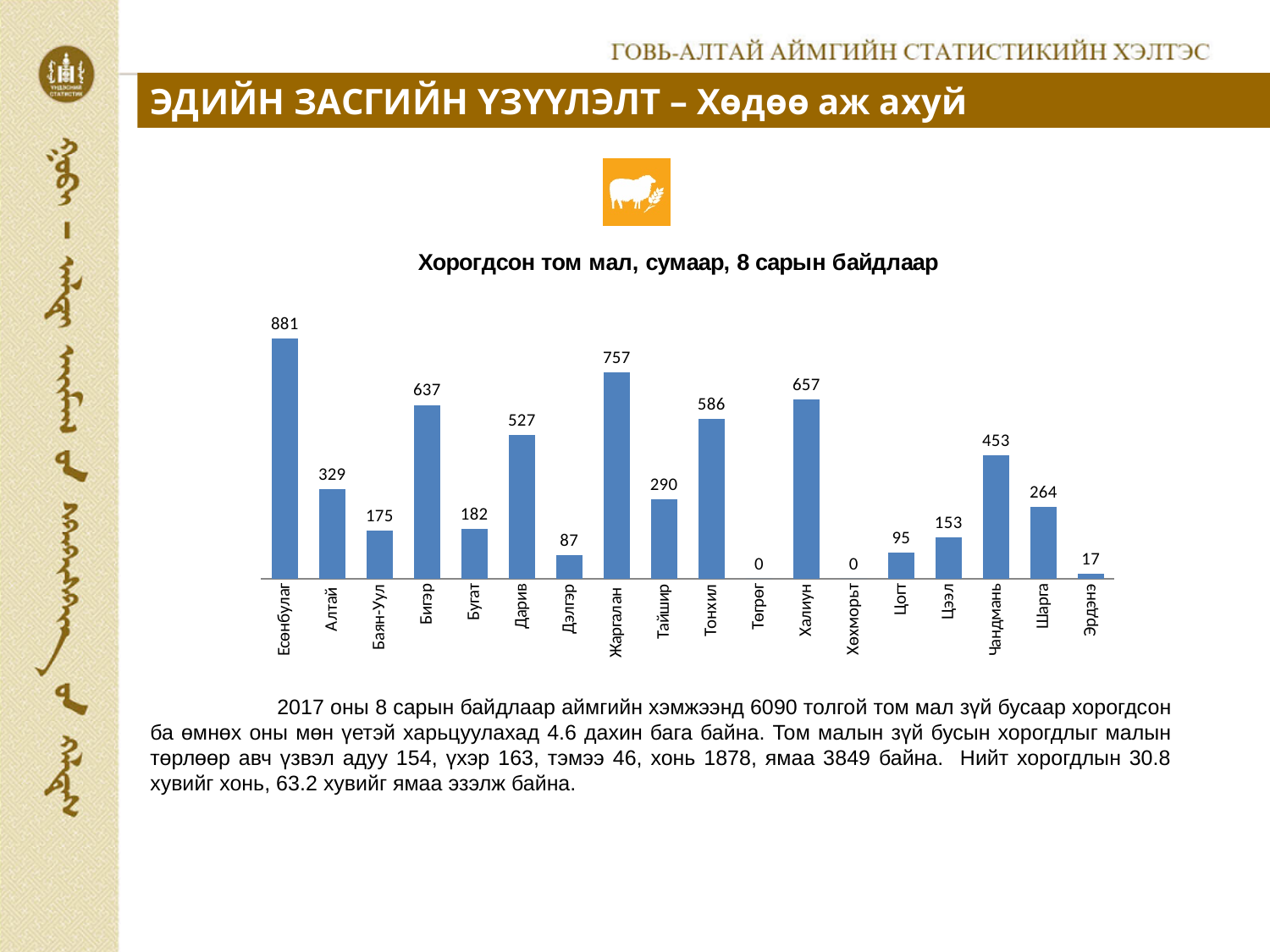
What is the difference between the values for Есөнбулаг and Жаргалан? 124 Which is larger, the value for Тонхил or the value for Чандмань? Тонхил What kind of chart is shown? Bar chart What is the value for Жаргалан? 757 What is the value for Есөнбулаг? 881 Which sum has the highest value? Есөнбулаг Which is larger, the value for Алтай or the value for Шарга? Алтай What is the value for Цээл? 153 What is the title of the chart? Хорогдсон том мал, сумаар, 8 сарын байдлаар Which sums have a value of 0? Төгрөг and Хөхморьт How many sums are shown on the x axis? 18 What is the difference between the values for Бигэр and Халиун? 20